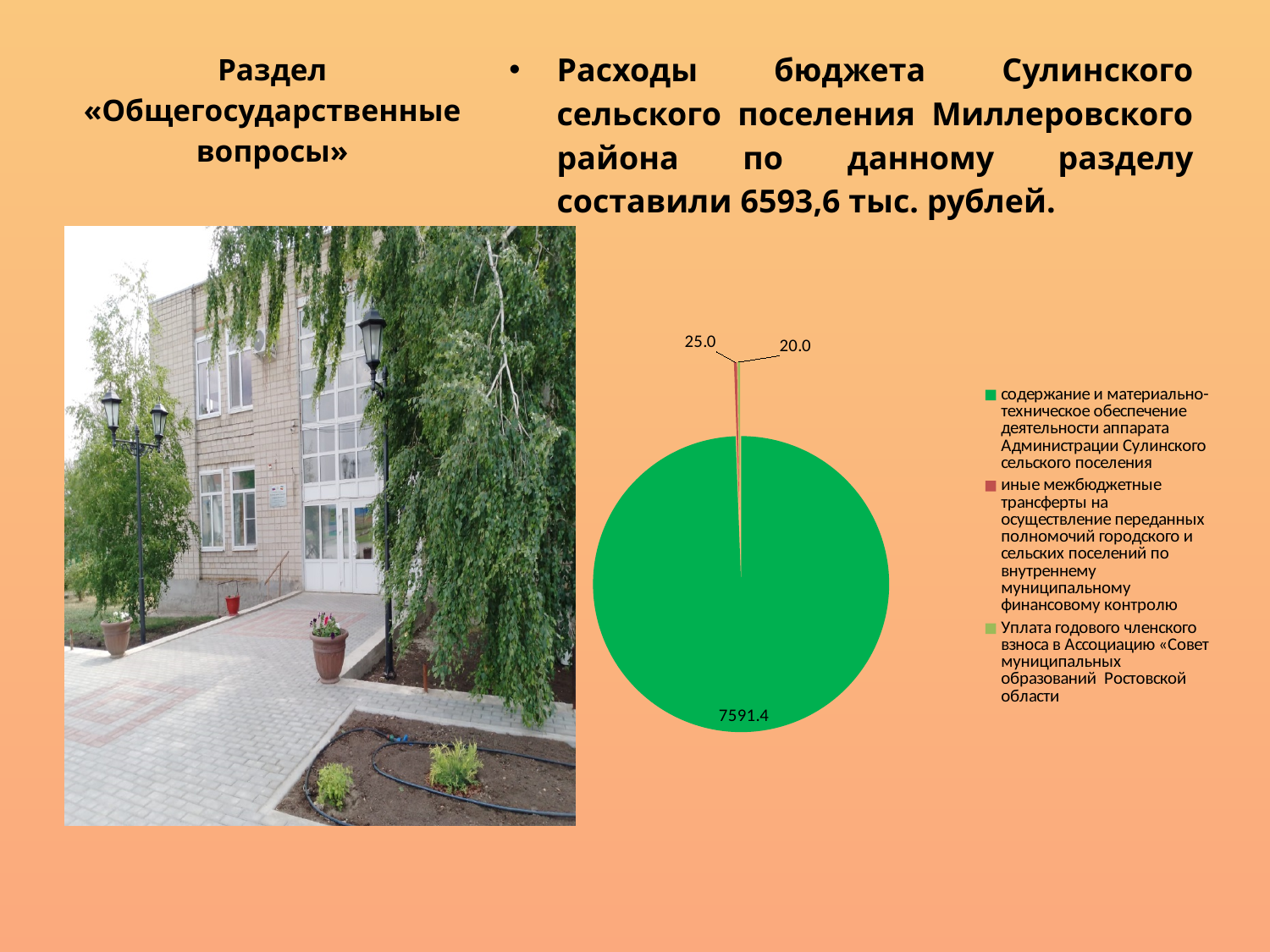
Which legend category has the largest slice in the pie chart? содержание и материально-техническое обеспечение деятельности аппарата Администрации Сулинского сельского поселения Which legend category has the smallest slice in the pie chart? Уплата годового членского взноса в Ассоциацию «Совет муниципальных образований Ростовской области Which is larger in the pie chart: the slice labelled 25.0 or the slice labelled 20.0? 25.0 How many entries does the legend of the pie chart list? 3 How many slices does the pie chart have? 3 What is the value of the largest slice of the pie chart? 7591.4 What is the total of all three slices in the pie chart? 7636.4 What colour is the largest slice of the pie chart? green What is the value for 'иные межбюджетные трансферты на осуществление переданных полномочий ... по внутреннему муниципальному финансовому контролю' in the pie chart? 25.0 What is the value for 'Уплата годового членского взноса в Ассоциацию «Совет муниципальных образований Ростовской области' in the pie chart? 20.0 What type of chart is shown on the slide? pie chart What is the difference between the two smallest slices of the pie chart (25.0 and 20.0)? 5.0